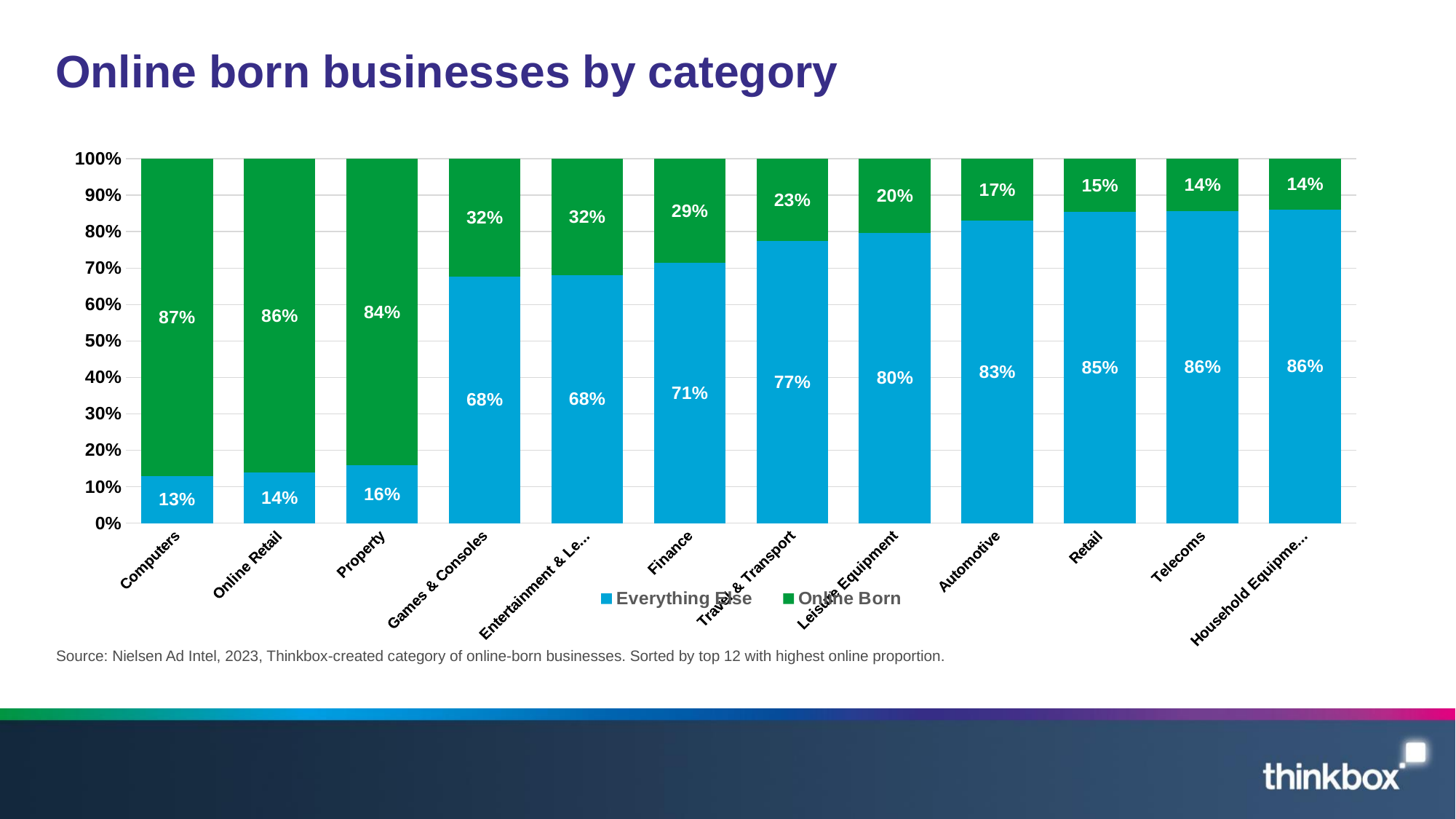
Which category has the lowest Everything Else share? Computers What is the Everything Else share for Finance? 71% How many categories are shown on the x axis? 12 How many series does the legend list? 2 What is the difference between the Online Born share for Property and the Online Born share for Retail? 69 percentage points What is the Online Born share for Computers? 87% What type of chart is shown on the slide? Stacked bar chart What is the Online Born share for Automotive? 17% Which is larger: the Online Born share for Games & Consoles or the Online Born share for Travel & Transport? Games & Consoles Which category has the highest Online Born share? Computers Which colour represents the Online Born series? Green Does the Online Born share generally rise or fall moving from left to right along the x axis? Fall